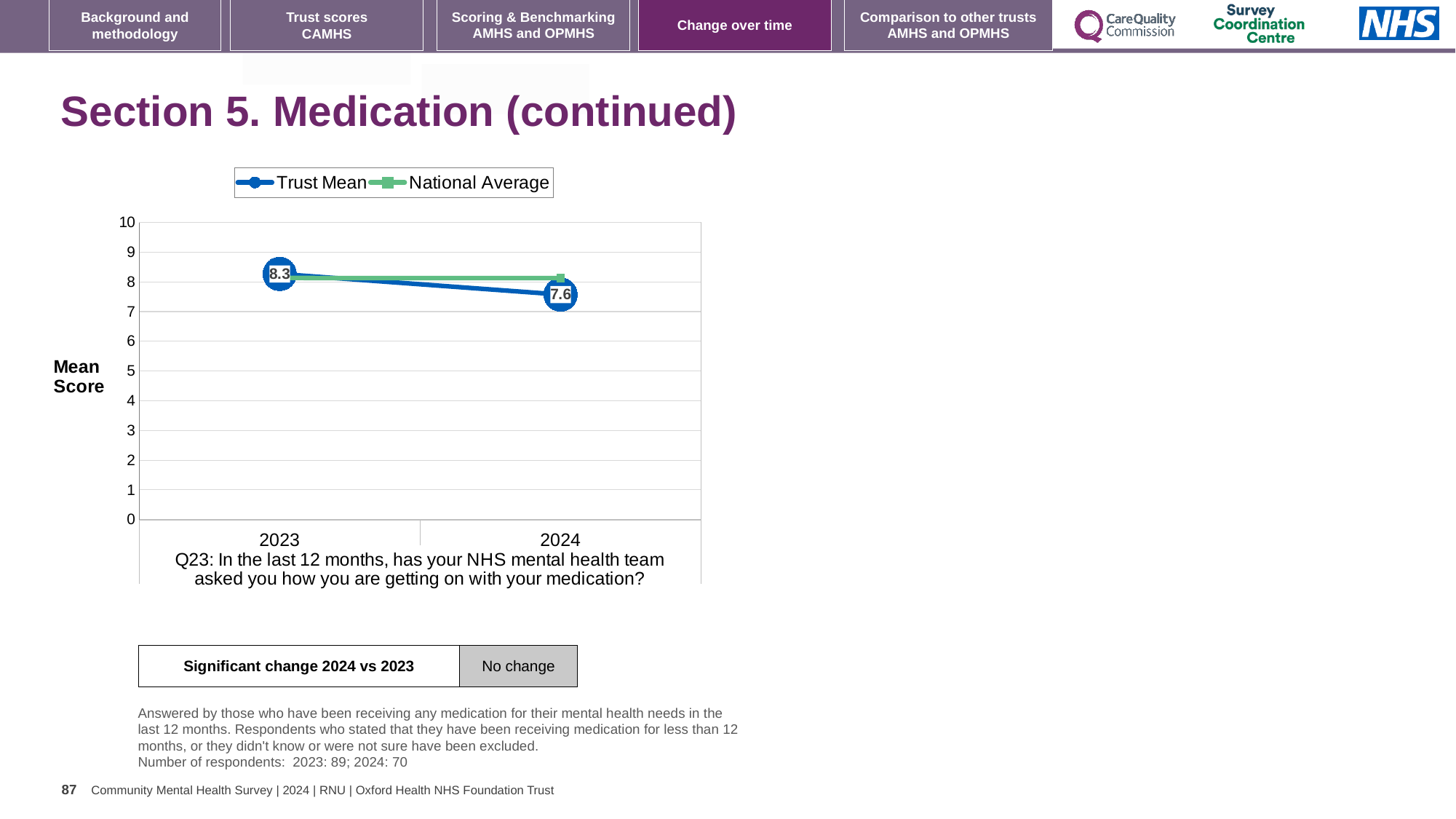
Does the Trust Mean rise or fall from 2023 to 2024? fall How many years are plotted on the x axis? 2 What kind of chart is shown on the slide? line chart What is the Trust Mean score for 2024? 7.6 What are the two series named in the legend? Trust Mean and National Average What is the label on the y axis of the chart? Mean Score What is the Trust Mean score for 2023? 8.3 Is the National Average value for 2024 greater or less than 5? greater By how much did the Trust Mean score fall from 2023 to 2024? 0.7 Which year has the higher Trust Mean score, 2023 or 2024? 2023 In 2024, which is higher: the Trust Mean or the National Average? National Average How many series does the legend list? 2